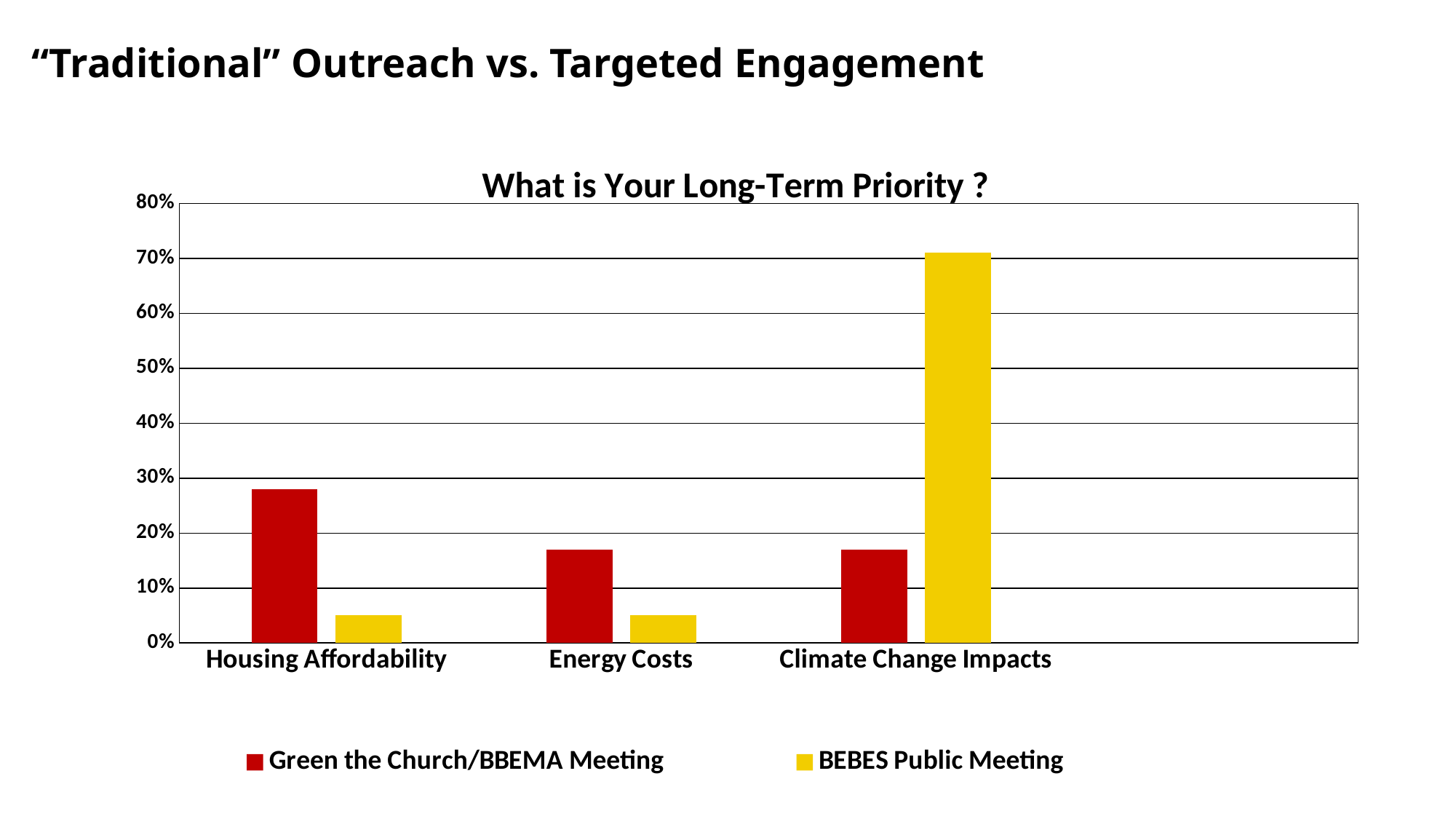
Is the BEBES Public Meeting value for Housing Affordability greater or less than 10%? less Which category has the highest bar for the BEBES Public Meeting series? Climate Change Impacts Which series is shown in yellow in the chart? BEBES Public Meeting How many categories are shown on the x axis of the chart? 3 How many series does the chart's legend list? 2 Is the BEBES Public Meeting value for Climate Change Impacts greater or less than 60%? greater For Climate Change Impacts, which series has the larger value: Green the Church/BBEMA Meeting or BEBES Public Meeting? BEBES Public Meeting What is the title of the chart? What is Your Long-Term Priority ? Is the Green the Church/BBEMA Meeting value for Housing Affordability greater or less than 20%? greater For Housing Affordability, which series has the larger value: Green the Church/BBEMA Meeting or BEBES Public Meeting? Green the Church/BBEMA Meeting Which category has the highest bar for the Green the Church/BBEMA Meeting series? Housing Affordability What kind of chart is shown on the slide? bar chart